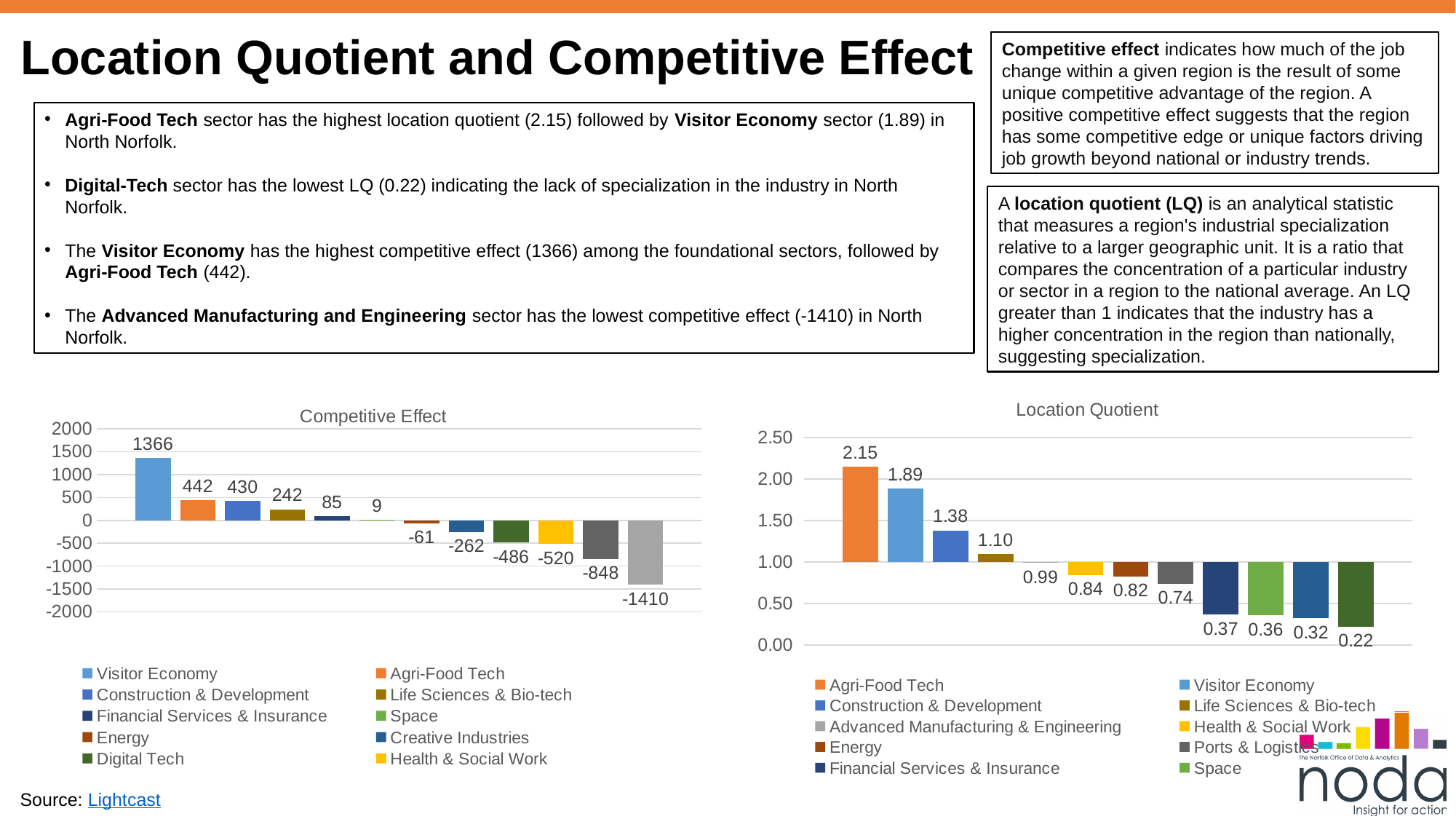
What type of chart is the Location Quotient chart? Bar chart In the Location Quotient chart, which sector has the highest value? Agri-Food Tech How many entries does the legend of the Competitive Effect chart list? 10 In the Competitive Effect chart, what is the difference between the values for Agri-Food Tech and Construction & Development? 12 In the Competitive Effect chart, which sector has the lowest value? Advanced Manufacturing & Engineering How many bars are plotted in the Competitive Effect chart? 12 In the Location Quotient chart, what is the value for Construction & Development? 1.38 In the Competitive Effect chart, which is larger, the value for Digital Tech or the value for Creative Industries? Creative Industries In the Location Quotient chart, do the values rise or fall from left to right? Fall In the Competitive Effect chart, what is the value for Visitor Economy? 1366 In the Location Quotient chart, what is the difference between the values for Agri-Food Tech and Visitor Economy? 0.26 In the Competitive Effect chart, what is the value for Health & Social Work? -520